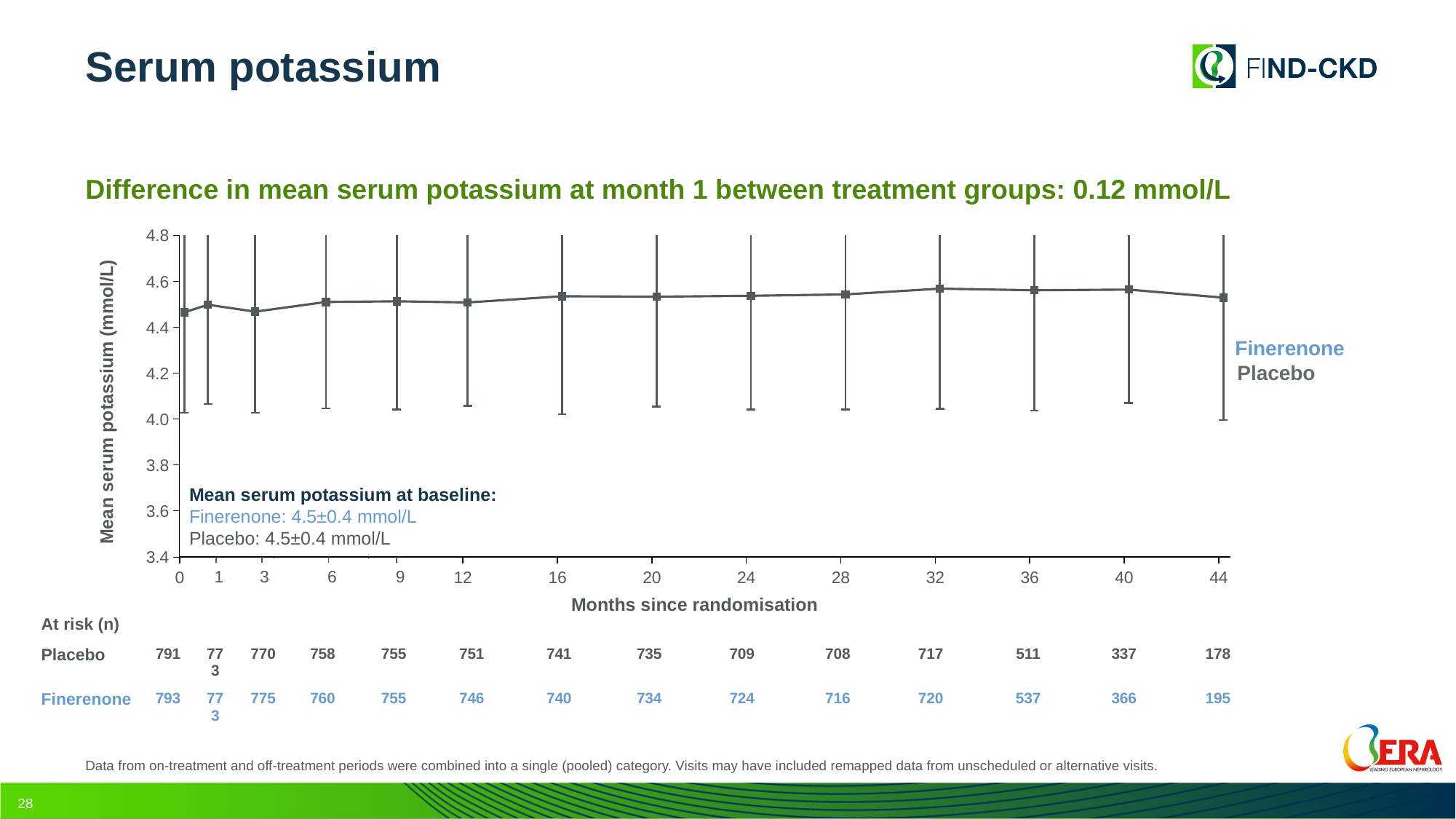
Is the mean serum potassium value at month 0 greater or less than 4.4? greater Is the mean serum potassium value at month 44 greater or less than 4.2? greater What kind of chart is shown on the slide? line chart Is the mean serum potassium value at month 32 greater or less than 4.8? less What is the mean serum potassium at baseline for the Finerenone group? 4.5±0.4 mmol/L In the at-risk table, how many Placebo patients were at risk at month 0? 791 In the at-risk table, which group has more patients at risk at month 40, Placebo or Finerenone? Finerenone What is the difference in mean serum potassium at month 1 between treatment groups stated on the slide? 0.12 mmol/L How many time points are plotted along the x axis? 14 In the at-risk table, how many Finerenone patients were at risk at month 44? 195 What is the label of the x axis? Months since randomisation What is the label of the y axis? Mean serum potassium (mmol/L)